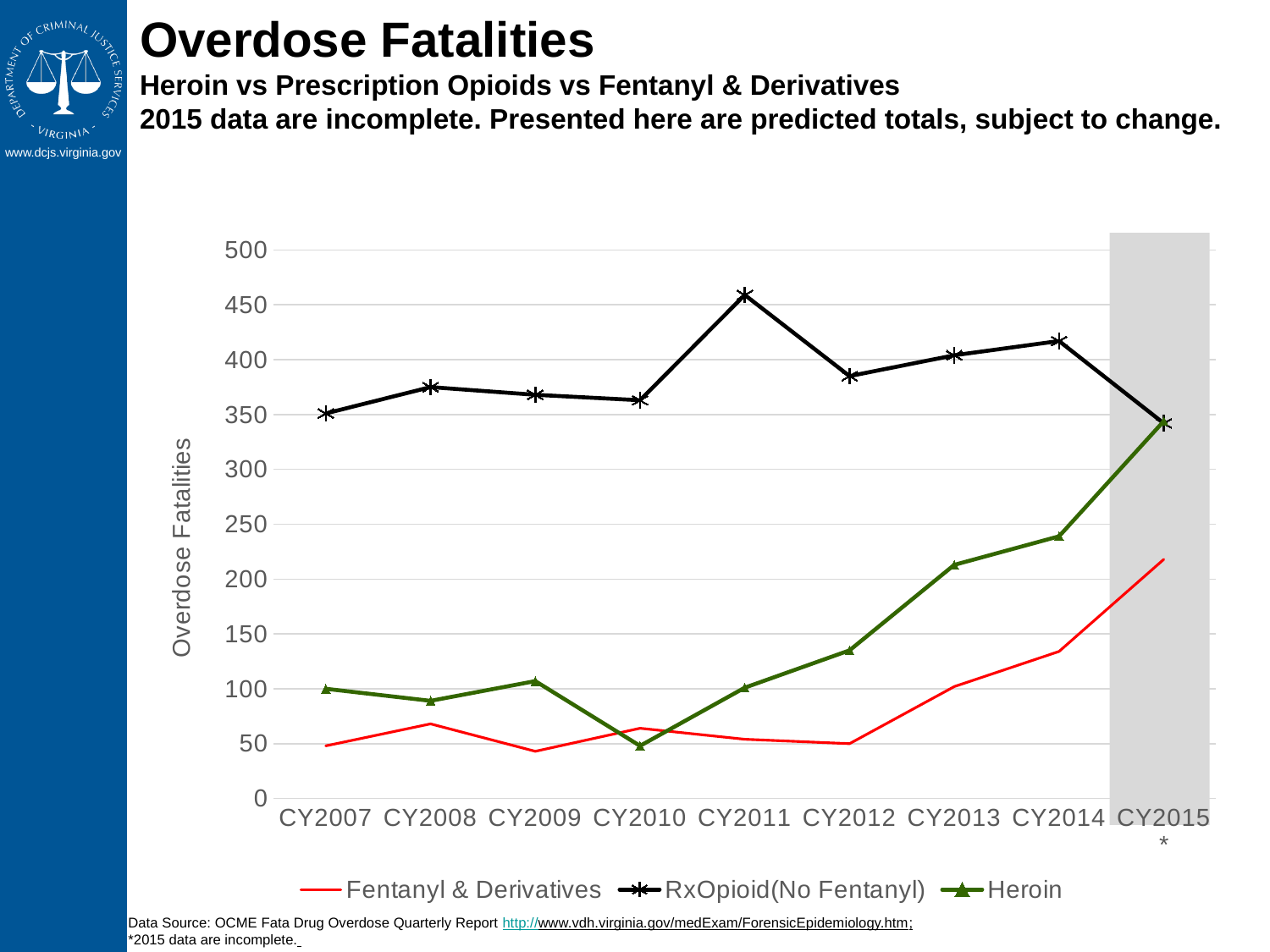
What kind of chart is shown on the slide? line chart In which year does the Fentanyl & Derivatives series reach its highest value? CY2015 Is the value for Fentanyl & Derivatives in CY2015 greater or less than 200? greater What is the label on the y axis? Overdose Fatalities Does the Heroin series rise or fall from CY2010 to CY2015? rise In which year does the RxOpioid(No Fentanyl) series reach its highest value? CY2011 How many series does the legend list? 3 In which year does the Heroin series reach its lowest value? CY2010 Which series has the larger value in CY2014, Heroin or Fentanyl & Derivatives? Heroin Is the value for RxOpioid(No Fentanyl) in CY2011 greater or less than 450? greater How many calendar years are shown on the x axis? 9